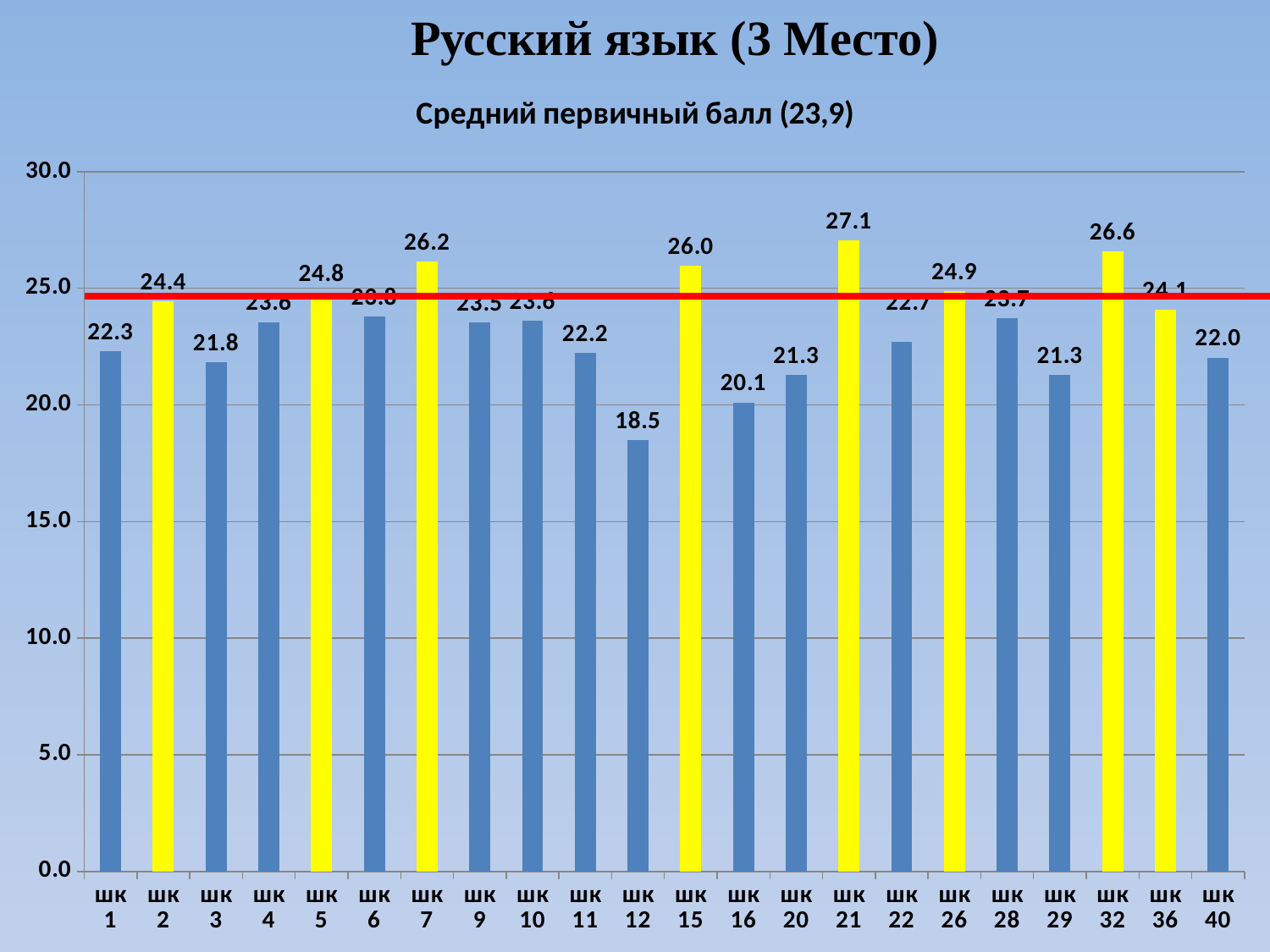
What is the value for шк 7? 26.2 What kind of chart is shown on the slide? bar chart Which is larger, the value for шк 32 or the value for шк 15? шк 32 What is the subtitle shown above the chart? Средний первичный балл (23,9) What is the value for шк 16? 20.1 What is the value for шк 21? 27.1 Which school has the lowest value? шк 12 What is the difference between the values for шк 21 and шк 12? 8.6 What is the value for шк 12? 18.5 Which school has the highest value? шк 21 Is the value for шк 2 greater or less than 25.0? less How many schools are shown on the chart? 22